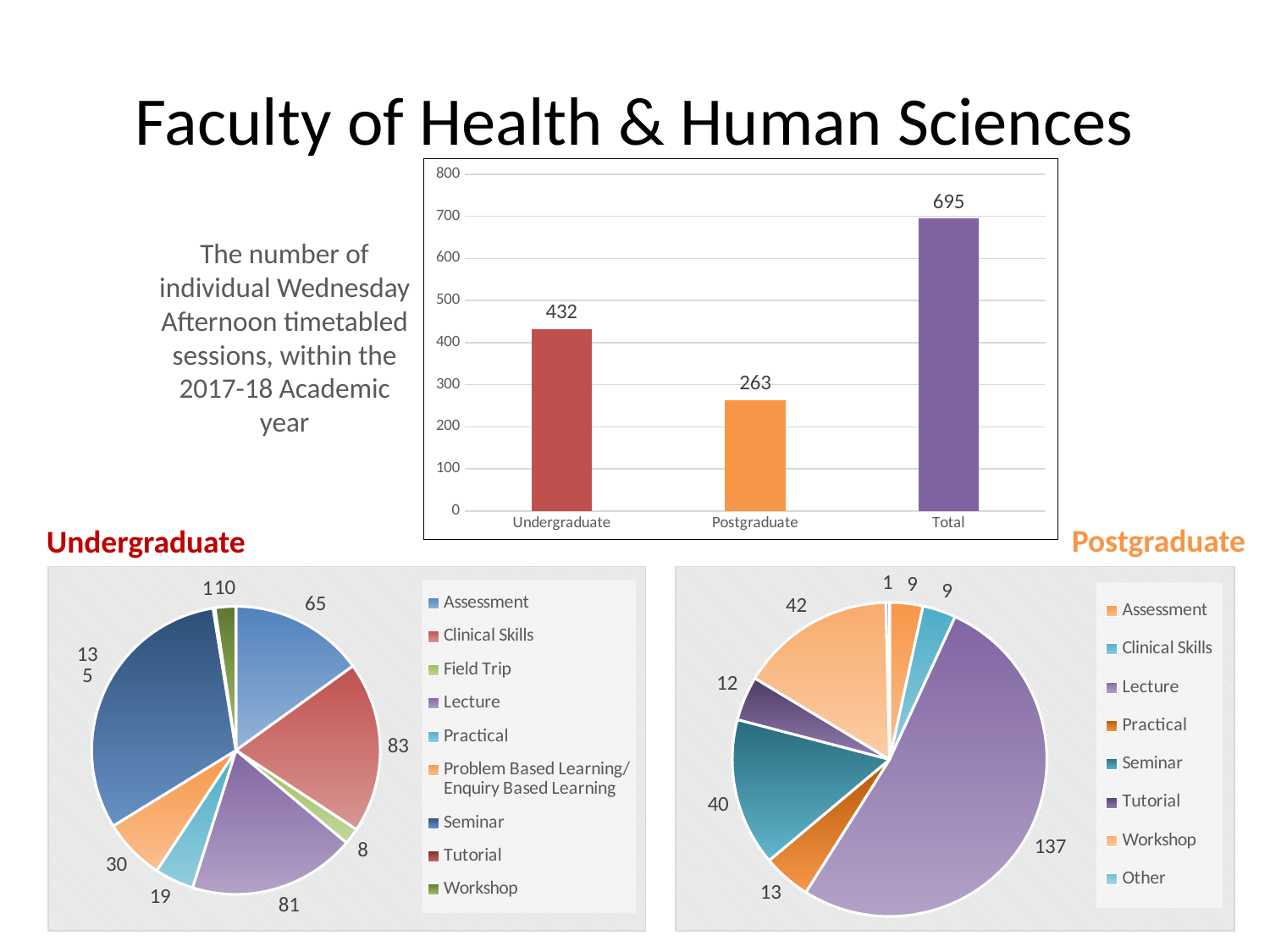
What kind of chart is the chart at the top of the slide? bar chart How many entries does the legend of the Undergraduate pie chart list? 9 In the bar chart, what is the value for Total? 695 In the Undergraduate pie chart, what is the value for Clinical Skills? 83 In the bar chart, what is the difference between the Undergraduate and Postgraduate values? 169 In the Undergraduate pie chart, which category has the largest slice? Seminar In the Postgraduate pie chart, which is larger, Workshop or Seminar? Workshop In the Undergraduate pie chart, which category has the smallest slice? Tutorial In the Postgraduate pie chart, what is the value for Lecture? 137 In the bar chart, what is the value for Postgraduate? 263 How many categories does the bar chart show? 3 In the Postgraduate pie chart, what is the difference between the Workshop and Seminar values? 2